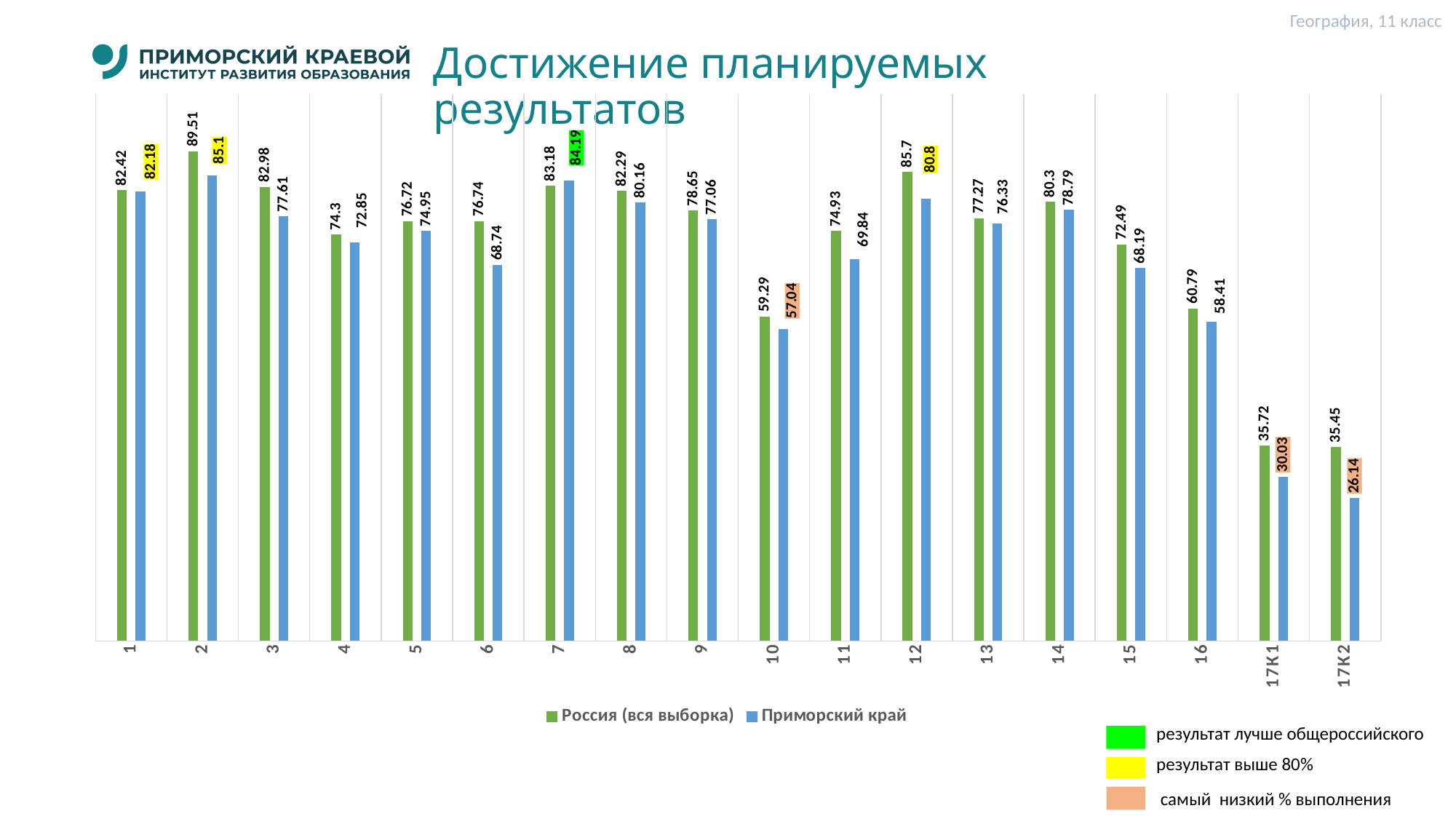
Which task has the highest value for Россия (вся выборка)? 2 How many task categories are shown on the x axis? 18 What is the difference between Россия (вся выборка) and Приморский край for task 17К2? 9.31 How many series does the chart legend list? 2 What is the value for Россия (вся выборка) for task 12? 85.7 What is the value for Приморский край for task 17К1? 30.03 For task 7, which series has the larger value: Россия (вся выборка) or Приморский край? Приморский край What kind of chart is shown on the slide? bar chart Which task has the lowest value for Приморский край? 17К2 According to the colour key, what does the green highlight on a data label mean? результат лучше общероссийского What is the value for Приморский край for task 7? 84.19 What is the difference between Россия (вся выборка) and Приморский край for task 6? 8